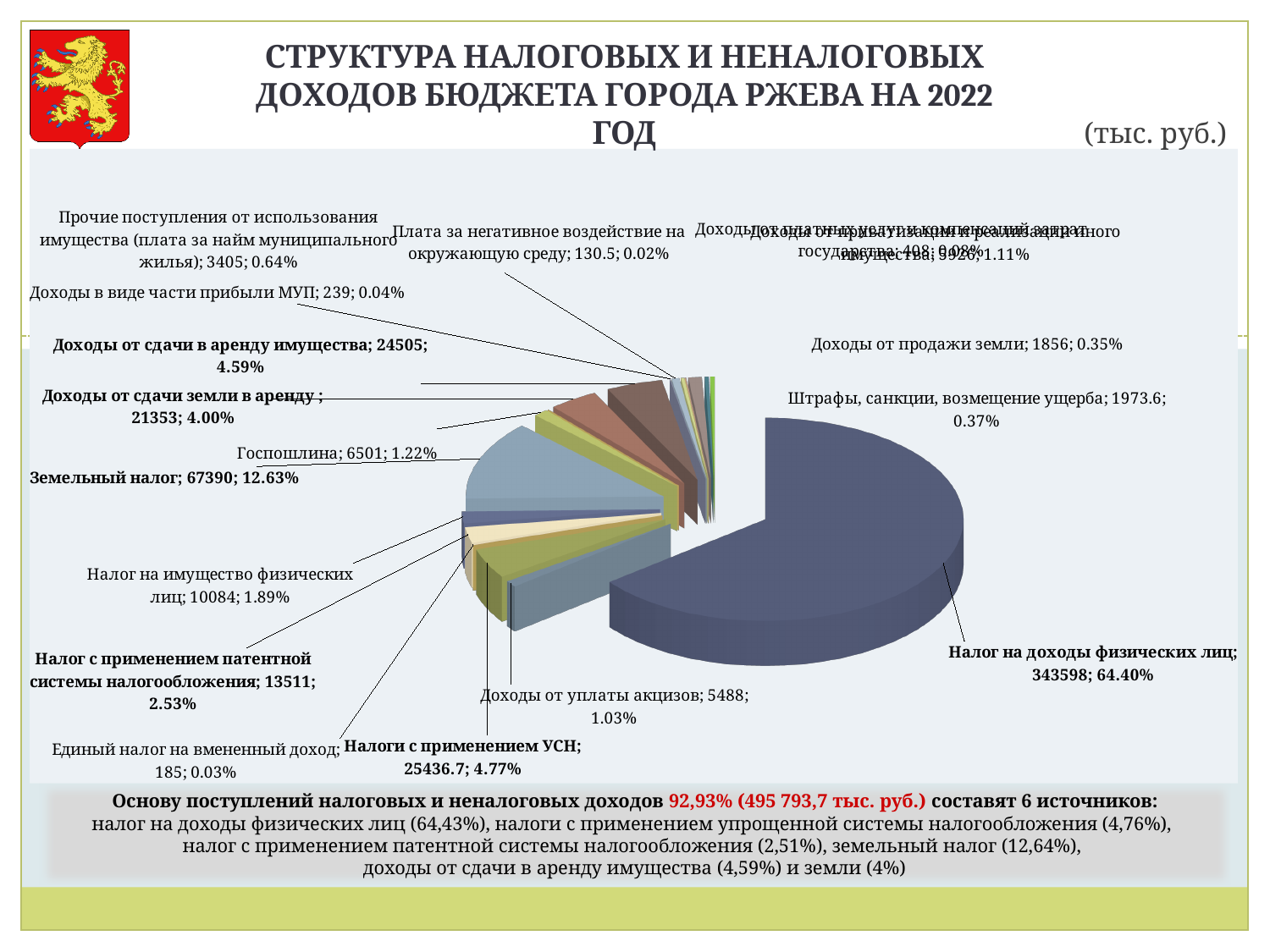
What share of the pie does Госпошлина represent? 1.22% What is the difference between the values for Доходы от сдачи в аренду имущества and Доходы от сдачи земли в аренду? 3152 What unit is indicated for the values in the chart? тыс. руб. What value is shown for Налог на доходы физических лиц? 343598 What share of the pie does Налог на доходы физических лиц represent? 64.40% What value is shown for Земельный налог? 67390 Which category has the largest slice of the pie? Налог на доходы физических лиц What share of the pie does Земельный налог represent? 12.63% Which is larger: the value for Налог с применением патентной системы налогообложения or the value for Налог на имущество физических лиц? Налог с применением патентной системы налогообложения What value is shown for Налоги с применением УСН? 25436.7 What kind of chart is shown on the slide? pie chart